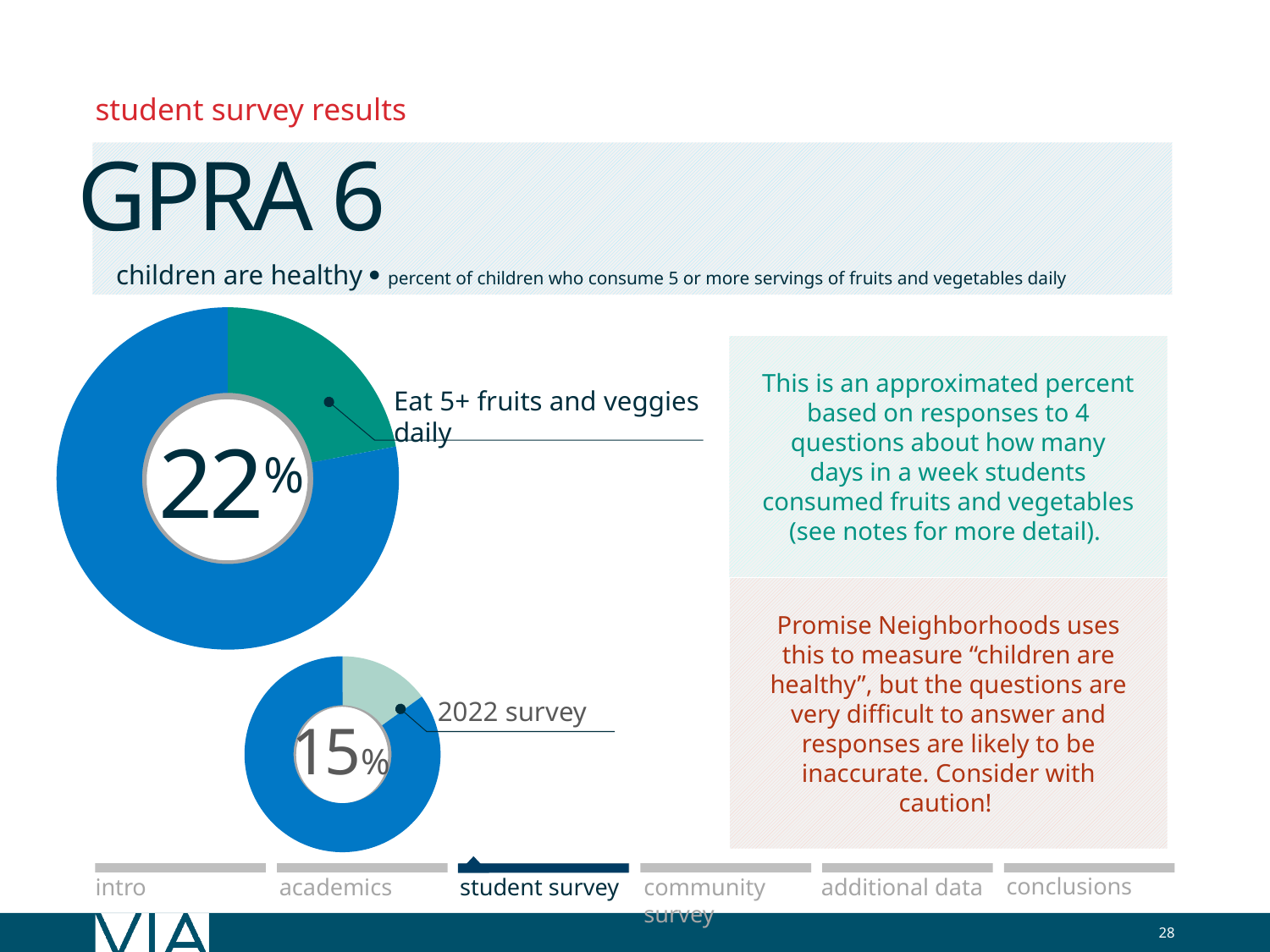
What kind of chart is used to show the 22% value on the slide? Donut (pie) chart What label is attached to the small donut chart? 2022 survey Is the value shown on the large donut chart greater or less than 20%? greater On the small donut chart labelled '2022 survey', what percent is shown in the centre? 15% On the large donut chart, what percent of children eat 5+ fruits and veggies daily? 22% What is the difference in percentage points between the large donut chart value (22%) and the small donut chart value (15%)? 7 percentage points On the large donut chart, what share of the ring does the green slice represent? 22% On the small donut chart, what share of the ring does the light green slice represent? 15% Is the value shown on the small donut chart (2022 survey) greater or less than 20%? less Which is larger: the percent on the large donut chart (Eat 5+ fruits and veggies daily) or the percent on the small donut chart (2022 survey)? The large donut chart (22%) How many donut charts are shown on the slide? 2 What label is attached to the green slice of the large donut chart? Eat 5+ fruits and veggies daily